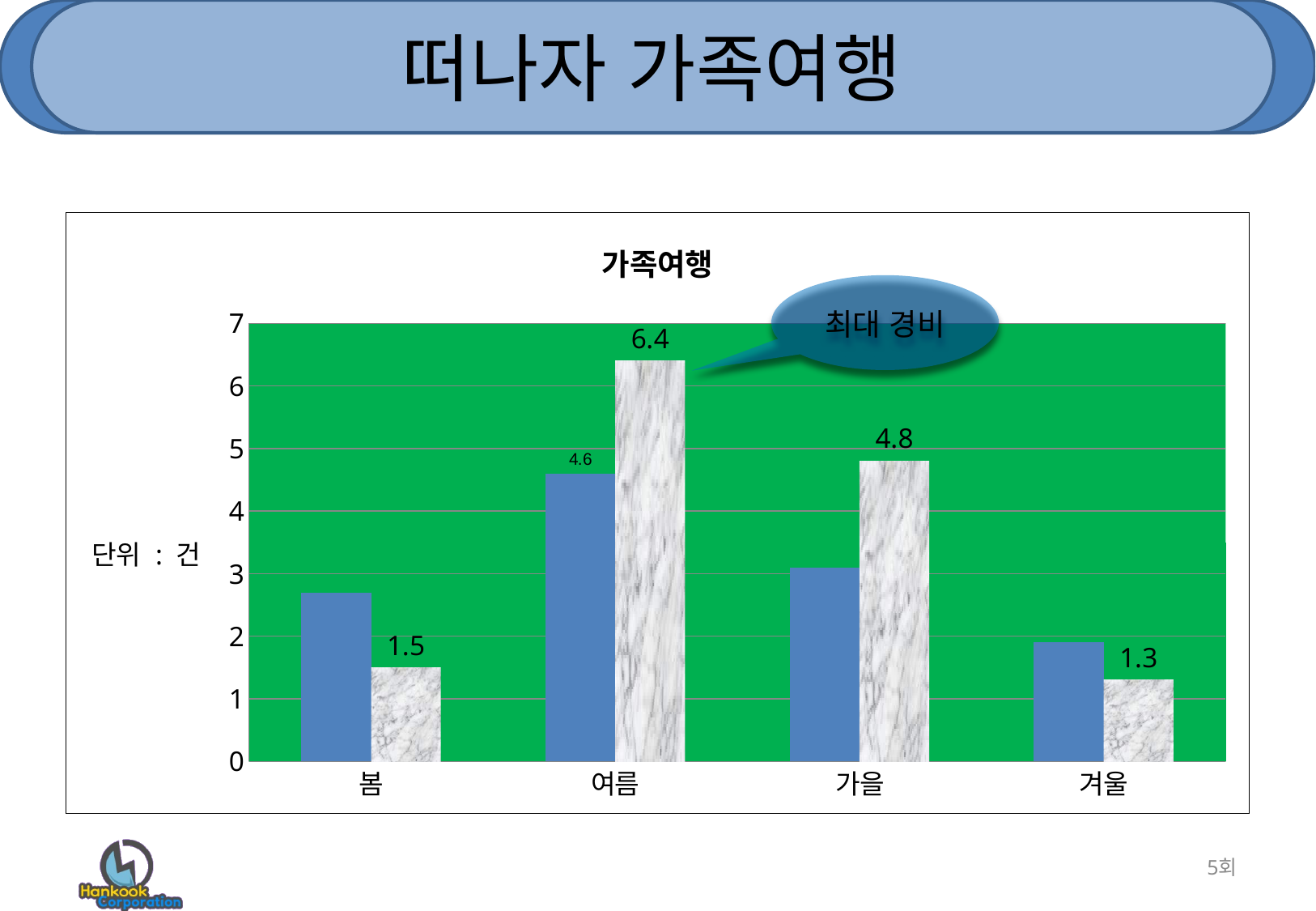
Is the value of the blue bar for 봄 greater or less than 3? less For 여름, which is larger: the blue bar or the marble-textured bar? the marble-textured bar Is the value of the blue bar for 가을 greater or less than 2? greater What is the difference between the marble-textured bars for 여름 and 가을? 1.6 What is the value of the marble-textured bar for 여름? 6.4 What is the value of the marble-textured bar for 가을? 4.8 How many categories are shown on the x axis? 4 What kind of chart is shown on the slide? bar chart Which category has the lowest marble-textured bar? 겨울 Which category has the highest marble-textured bar? 여름 What is the value of the marble-textured bar for 겨울? 1.3 What is the value of the blue bar for 여름? 4.6